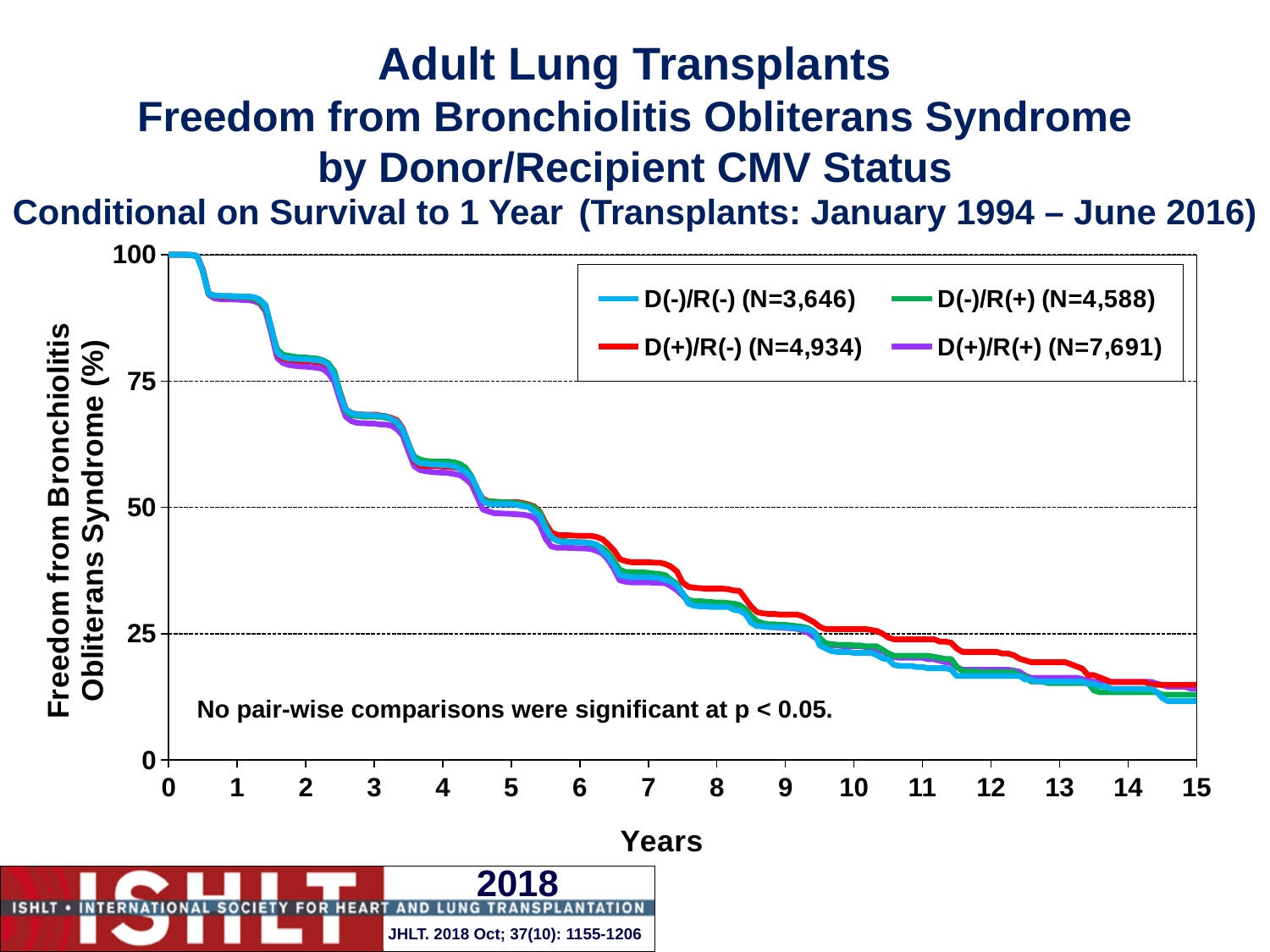
Do the curves rise or fall as the number of years increases? fall Is the value for D(+)/R(-) at 8 years greater or less than 25? greater At 8 years, which is higher: D(+)/R(-) or D(-)/R(-)? D(+)/R(-) At 12 years, which is higher: D(+)/R(-) or D(-)/R(-)? D(+)/R(-) What is the maximum value shown on the x axis (Years)? 15 According to the legend, what is the N for the D(+)/R(+) group? N=7,691 How many series does the legend list? 4 Is the value for D(-)/R(+) at 3 years greater or less than 75? less Is the value for D(-)/R(-) at 12 years greater or less than 25? less What kind of chart is shown on the slide? line chart What colour is the line for D(+)/R(-) in the legend? red